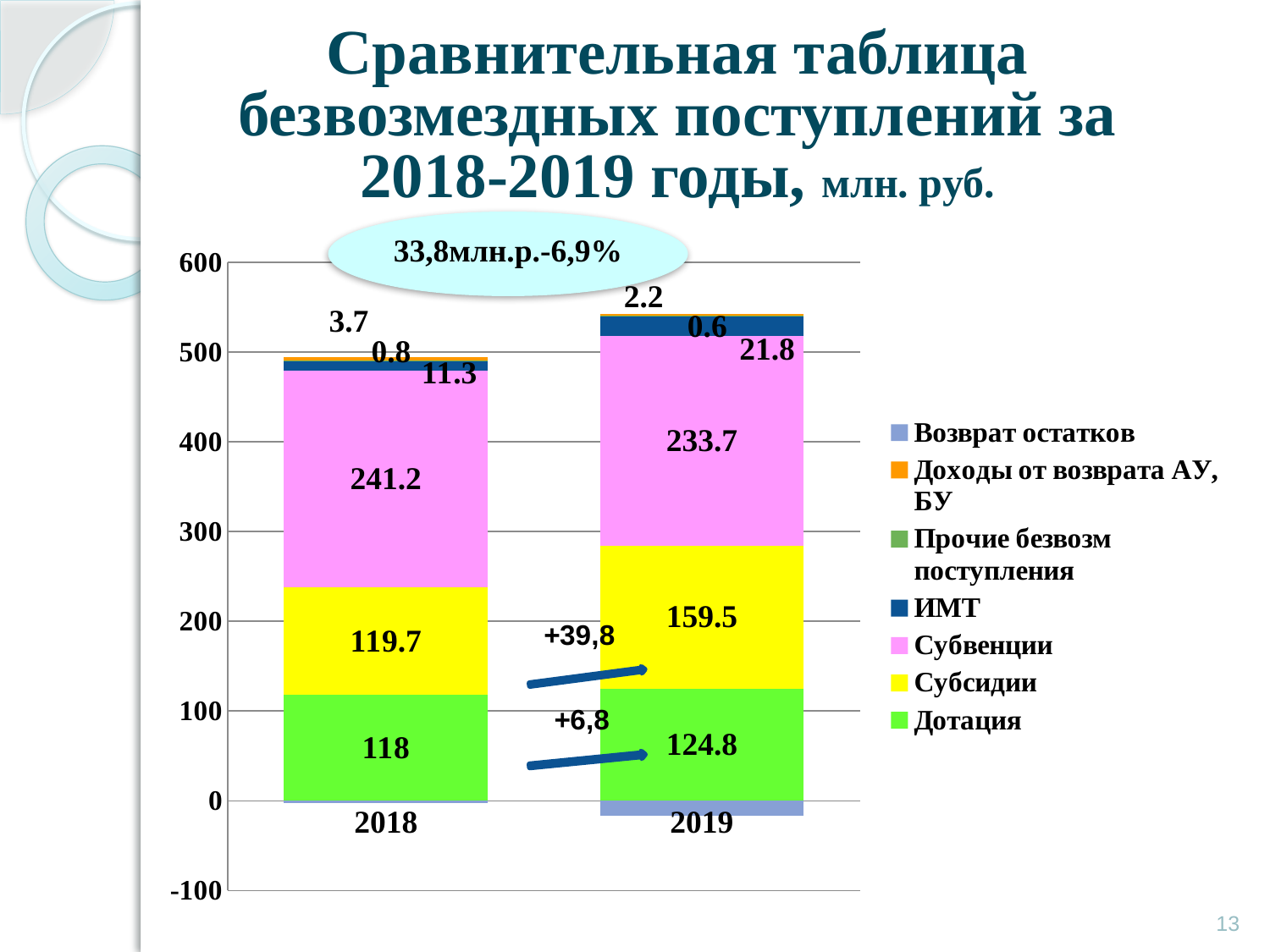
Which year has the larger value for Субвенции, 2018 or 2019? 2018 What is the value of Субвенции for 2018? 241.2 What is the difference between Дотация in 2019 and in 2018? 6.8 What is the value of Дотация for 2018? 118 Which series has the largest segment in the 2019 bar? Субвенции What is the value of Субсидии for 2019? 159.5 By how much did Субсидии increase from 2018 to 2019? 39.8 What colour represents Дотация in the legend? Green What kind of chart is shown on the slide? Stacked bar chart What is the value of ИМТ for 2019? 21.8 How many series does the legend list? 7 How many years (categories) are plotted on the x axis? 2